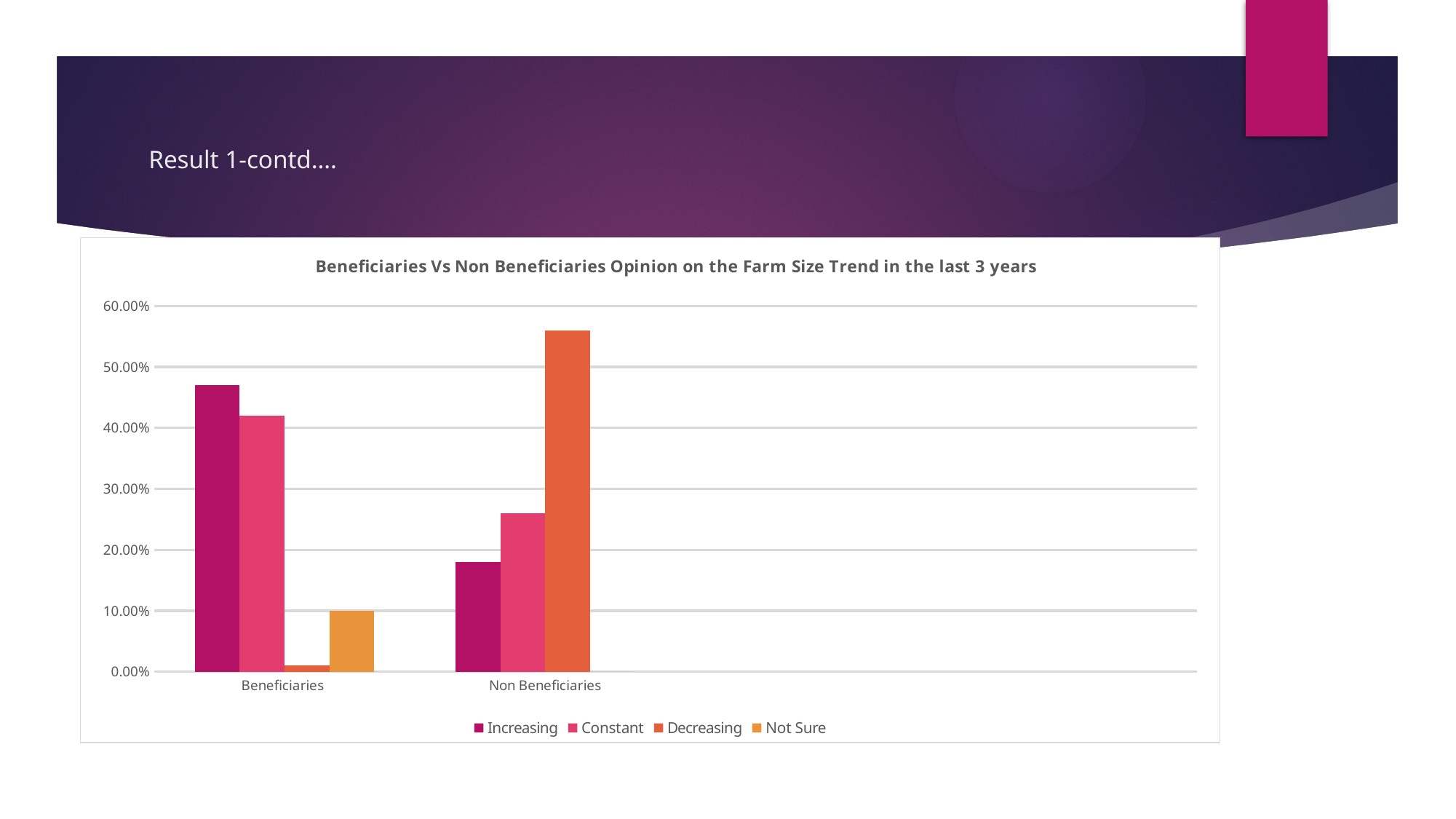
For Non Beneficiaries, which is larger: the Constant value or the Decreasing value? Decreasing Is the Increasing value for Non Beneficiaries greater or less than 20.00%? less Is the Increasing value larger for Beneficiaries or for Non Beneficiaries? Beneficiaries How many categories are shown on the x axis? 2 Which series has the highest value for Beneficiaries? Increasing Is the Decreasing value for Non Beneficiaries greater or less than 50.00%? greater Is the Constant value for Beneficiaries greater or less than 40.00%? greater What is the title of the chart? Beneficiaries Vs Non Beneficiaries Opinion on the Farm Size Trend in the last 3 years Which series has the lowest value for Beneficiaries? Decreasing Which series has the highest value for Non Beneficiaries? Decreasing How many series does the legend list? 4 What kind of chart is shown on the slide? bar chart